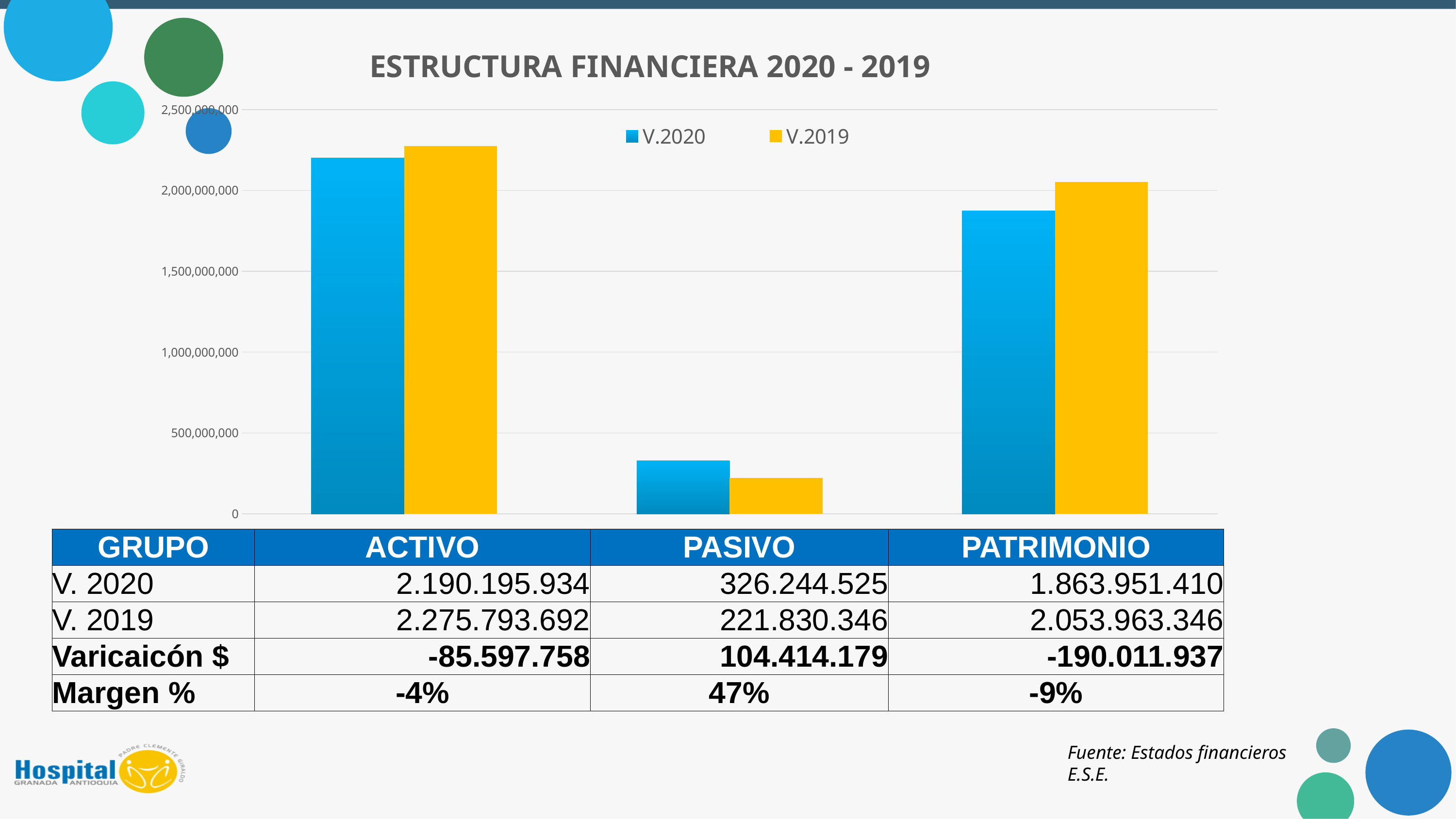
Which group has the highest value for V. 2019? ACTIVO What kind of chart is shown on the slide? bar chart What is the value of PATRIMONIO for V. 2020? 1.863.951.410 Which is larger for PATRIMONIO, the V. 2020 value or the V. 2019 value? V. 2019 What is the value of ACTIVO for V. 2020? 2.190.195.934 What is the value of PASIVO for V. 2019? 221.830.346 What is the difference between the V. 2020 and V. 2019 values for PASIVO? 104.414.179 How many category groups of bars are plotted in the chart? 3 Which group has the lowest value for V. 2020? PASIVO Is the V. 2020 value for PASIVO greater or less than 500,000,000? less How many series does the chart legend list? 2 What is the title of the chart? ESTRUCTURA FINANCIERA 2020 - 2019